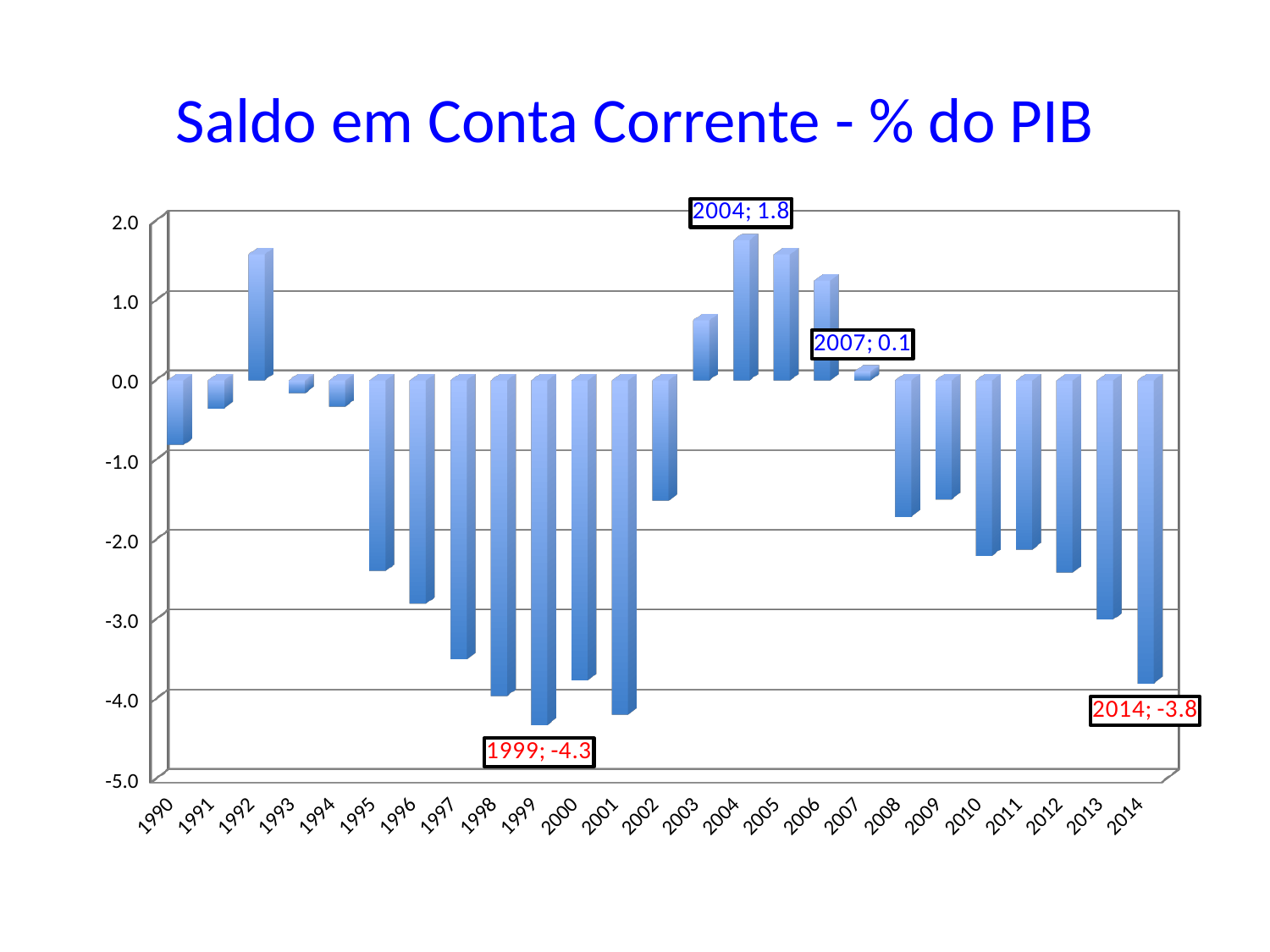
Which is larger, the value for 1996 or the value for 2002? 2002 What is the value for 1999? -4.3 Is the value for 2013 greater or less than -2.0? less What is the difference between the values for 2014 and 1999? 0.5 Do the values rise or fall from 2004 to 2007? fall What is the value for 2007? 0.1 Is the value for 1992 greater or less than 1.0? greater What is the difference between the values for 2004 and 1999? 6.1 What is the value for 2004? 1.8 Which year has the highest value? 2004 How many years are shown on the x axis? 25 What is the value for 2014? -3.8